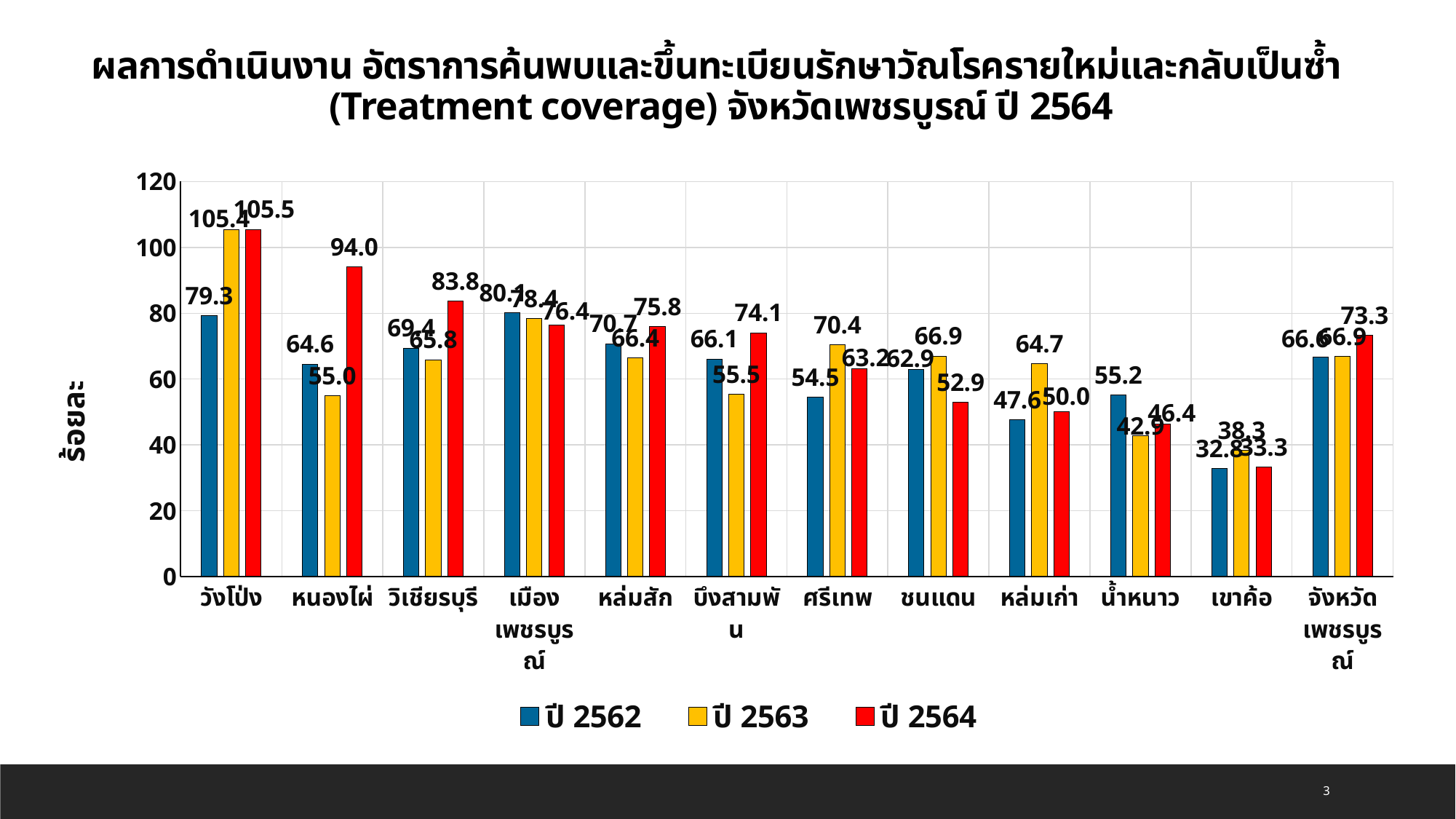
What is the value for ศรีเทพ in the ปี 2563 series? 70.4 How many series does the legend list? 3 What kind of chart is shown on the slide? bar chart Which category has the highest value in the ปี 2564 series? วังโป่ง Which is larger for บึงสามพัน: the ปี 2562 value or the ปี 2564 value? ปี 2564 Is the ปี 2563 value for น้ำหนาว greater or less than 60? less Which colour represents the ปี 2564 series? red What is the value for วังโป่ง in the ปี 2562 series? 79.3 What is the difference between the ปี 2564 and ปี 2563 values for หนองไผ่? 39.0 How many categories are shown on the x axis? 12 What is the value for หนองไผ่ in the ปี 2564 series? 94.0 Which category has the lowest value in the ปี 2562 series? เขาค้อ